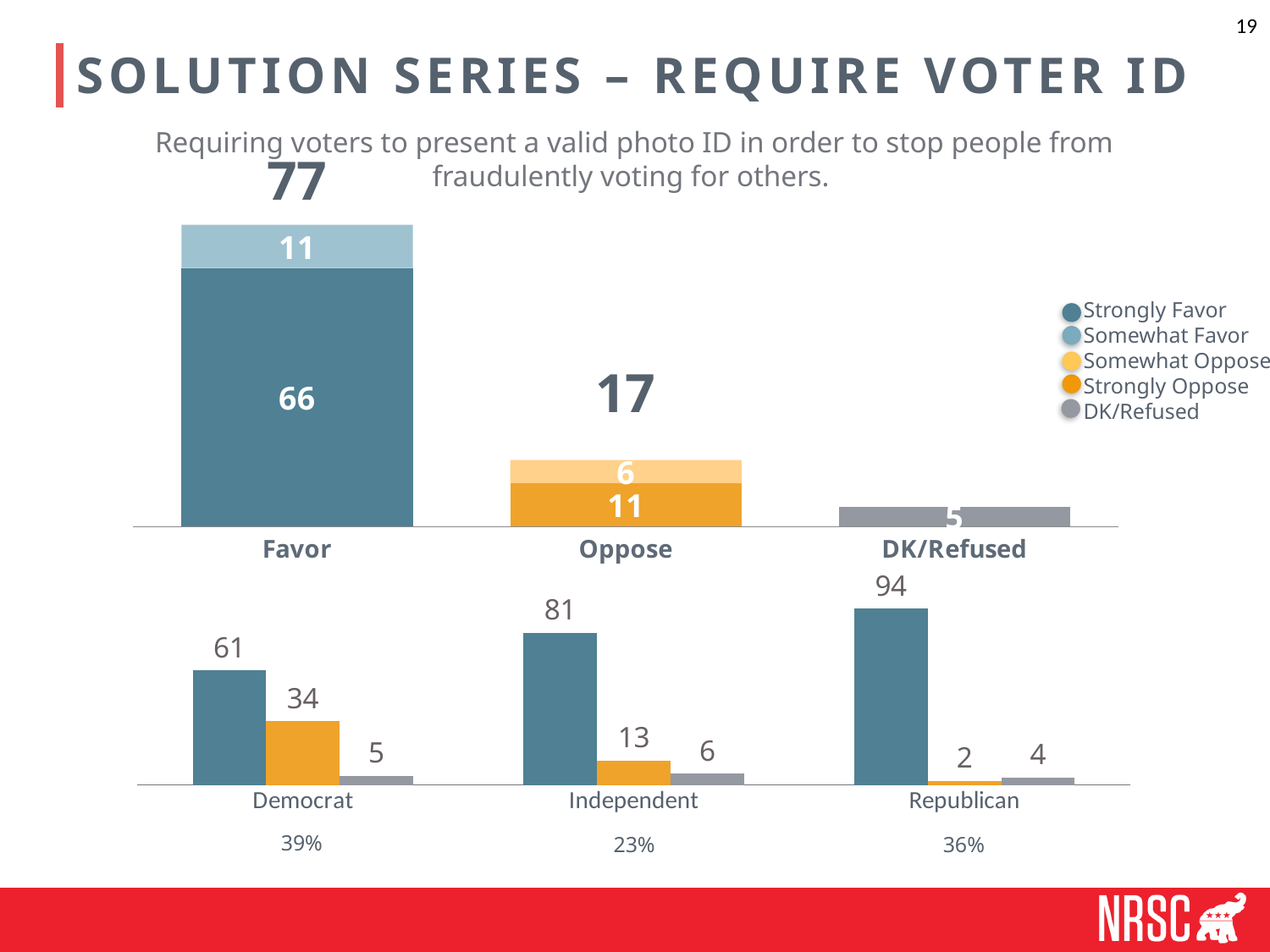
In the top chart, which category has the lowest total? DK/Refused In the top chart, how many entries does the legend list? 5 In the top chart, what is the total value of the Favor bar? 77 In the top chart, what is the Somewhat Oppose value within the Oppose bar? 6 In the bottom chart, which party group has the highest value for its first (Strongly Favor-coloured) bar? Republican What kind of chart is the bottom chart? Bar chart In the top chart, what is the difference between the Favor total and the Oppose total? 60 In the bottom chart, how many party groups are shown on the x axis? 3 In the bottom chart, what is the value of the orange bar for Democrat? 34 In the top chart, what is the Strongly Favor value within the Favor bar? 66 In the bottom chart, what is the value of the tallest bar for Republican? 94 In the bottom chart, what is the difference between the Independent first bar (81) and the Democrat first bar (61)? 20